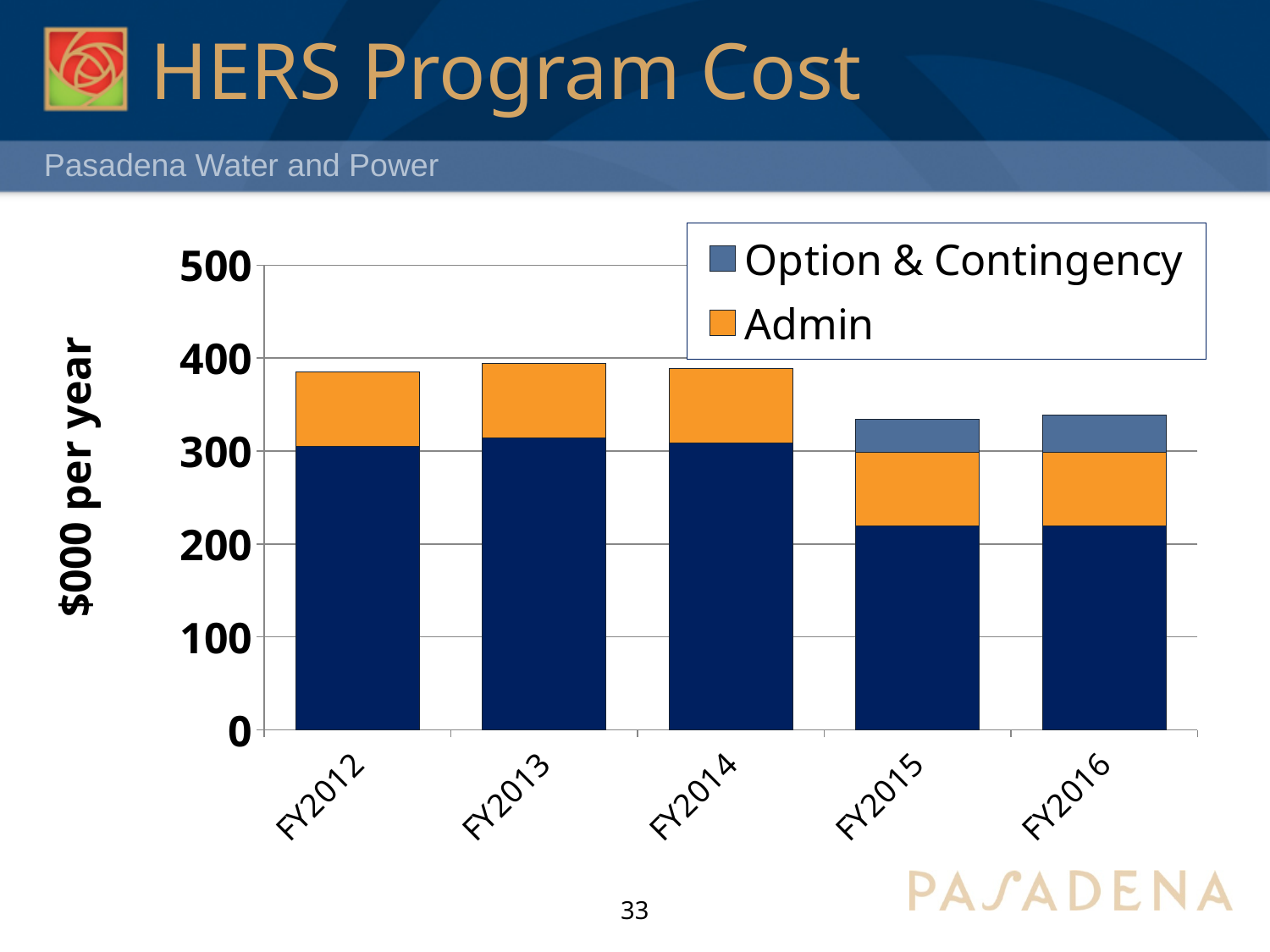
Is the total bar height for FY2012 greater or less than 300? greater Is the total bar height for FY2015 greater or less than 400? less Is the dark blue (bottom) segment for FY2016 greater or less than 200? greater What kind of chart is shown on the slide? Stacked bar chart What is the label on the vertical axis of the chart? $000 per year Which has the larger total bar, FY2012 or FY2015? FY2012 Which colour represents Admin in the chart legend? Orange Do the total bar heights rise or fall from FY2014 to FY2015? fall How many fiscal years are shown on the x axis of the chart? 5